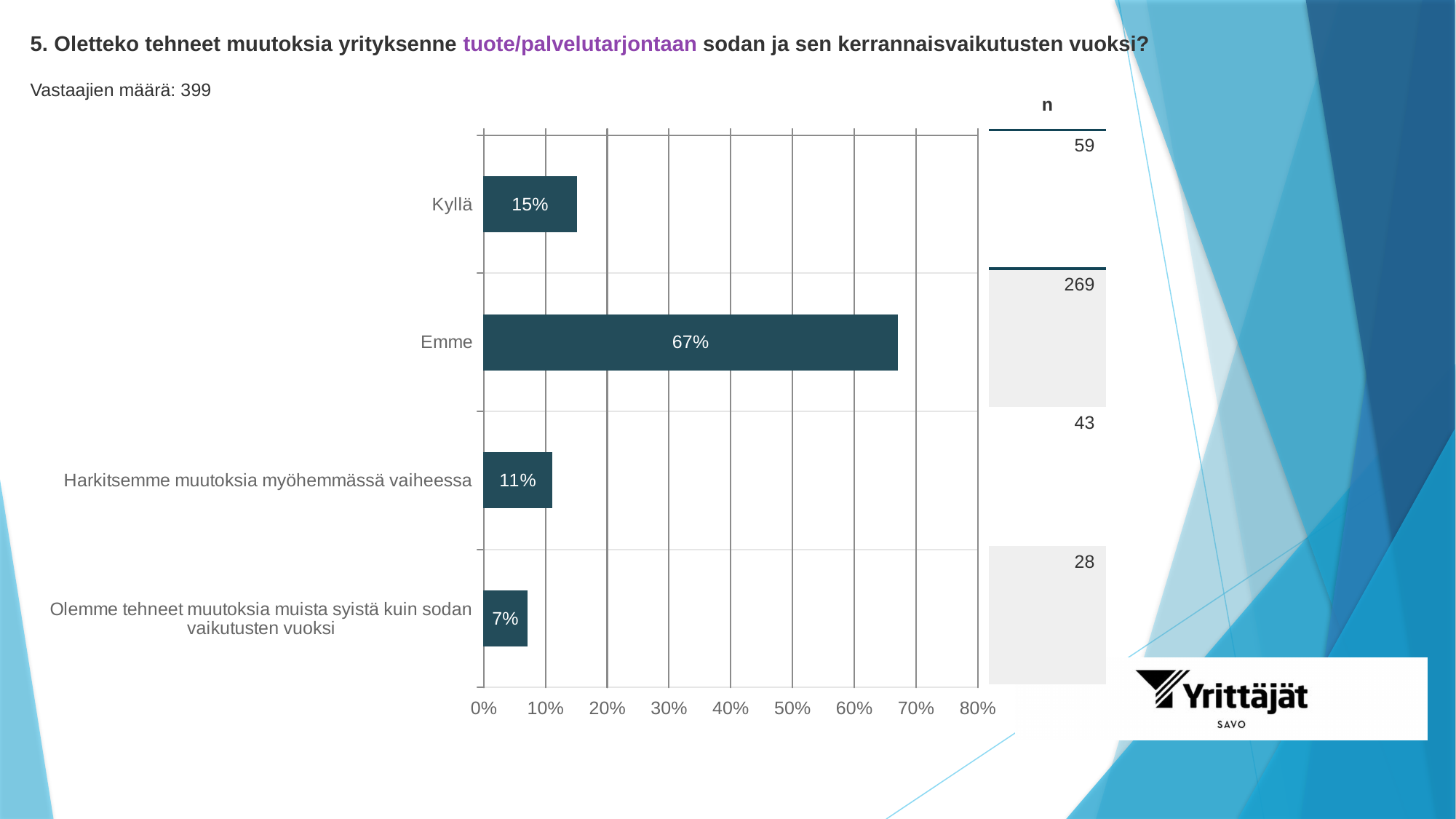
What kind of chart is shown on the slide? Bar chart What percentage is shown for "Olemme tehneet muutoksia muista syistä kuin sodan vaikutusten vuoksi"? 7% Which category has the highest percentage? Emme What percentage is shown for "Harkitsemme muutoksia myöhemmässä vaiheessa"? 11% Which category has the lowest percentage? Olemme tehneet muutoksia muista syistä kuin sodan vaikutusten vuoksi What percentage is shown for "Emme"? 67% What percentage is shown for "Kyllä"? 15% How many categories are shown in the chart? 4 Which is larger, the percentage for "Kyllä" or for "Harkitsemme muutoksia myöhemmässä vaiheessa"? Kyllä What is the difference in percentage points between "Emme" and "Kyllä"? 52 What is the n value listed for "Emme"? 269 What is the n value listed for "Kyllä"? 59